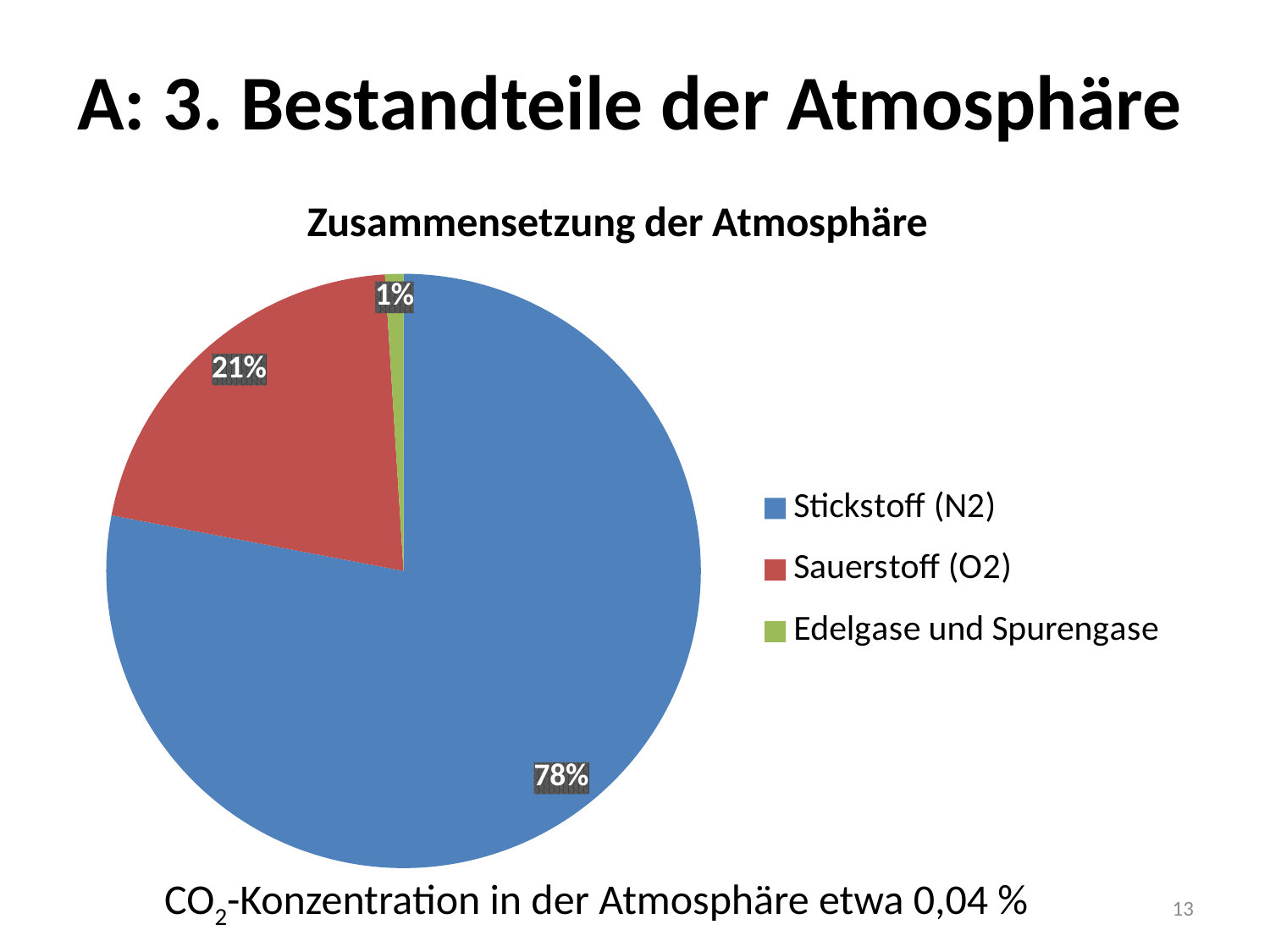
What kind of chart is shown on the slide? Pie chart What is the difference between the shares of Stickstoff (N2) and Sauerstoff (O2)? 57% Which category has the largest slice of the pie? Stickstoff (N2) Which category has the smallest slice of the pie? Edelgase und Spurengase What is the title of the chart? Zusammensetzung der Atmosphäre What share of the pie does Stickstoff (N2) have? 78% What is the combined share of Sauerstoff (O2) and Edelgase und Spurengase? 22% What share of the pie does Edelgase und Spurengase have? 1% Which is larger, the share of Sauerstoff (O2) or the share of Edelgase und Spurengase? Sauerstoff (O2) How many categories does the pie chart show? 3 Which colour represents Sauerstoff (O2) in the chart? Red What share of the pie does Sauerstoff (O2) have? 21%